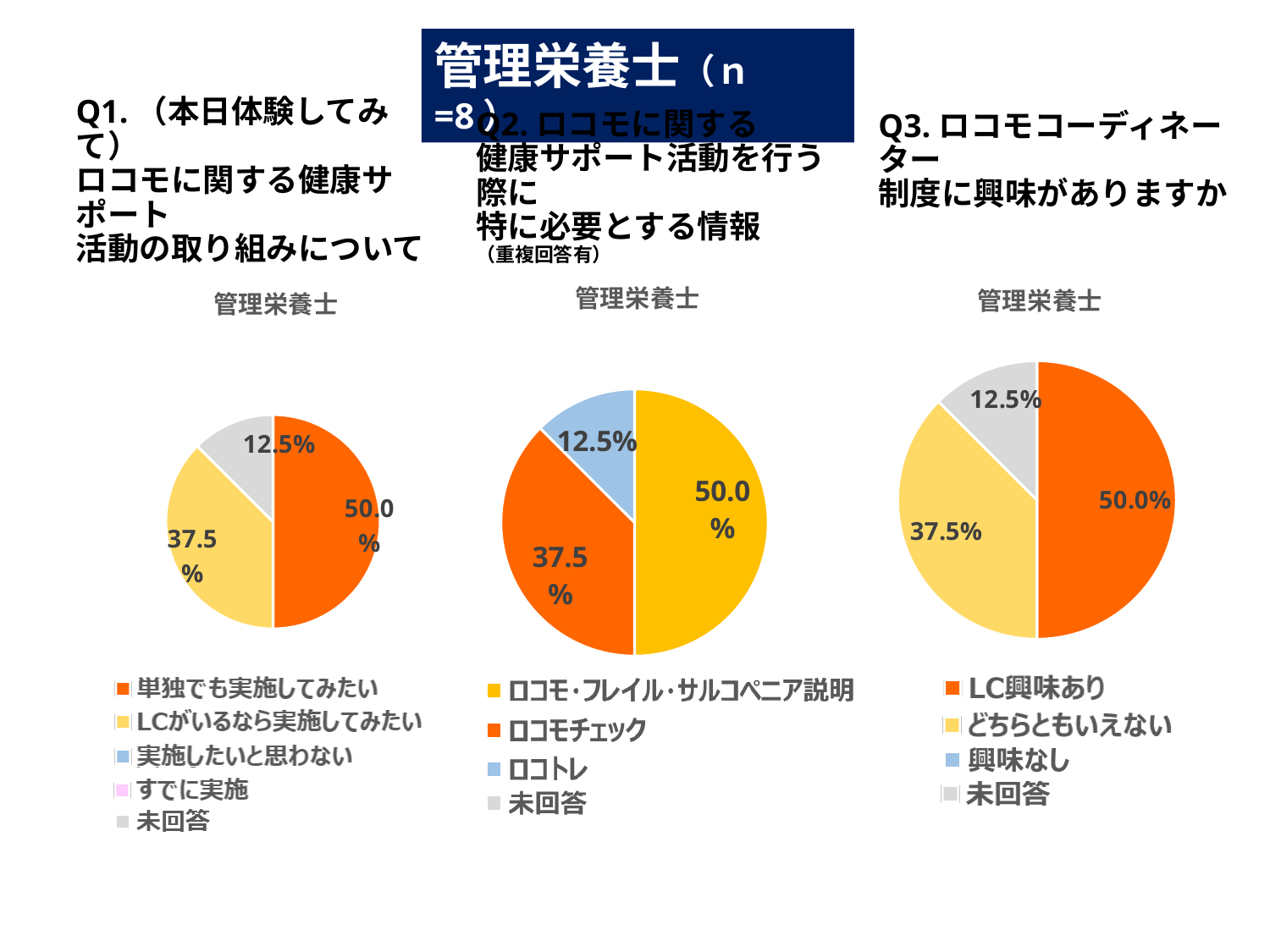
In the left pie chart (Q1), what share is labelled for 未回答? 12.5% In the right pie chart (Q3), what share is labelled for LC興味あり? 50.0% In the left pie chart (Q1), what share is labelled for LCがいるなら実施してみたい? 37.5% In the middle pie chart (Q2), which category has the smallest slice? ロコトレ In the left pie chart (Q1), which category has the largest slice? 単独でも実施してみたい In the left pie chart (Q1), how many entries does the legend list? 5 In the right pie chart (Q3), which is larger, どちらともいえない or 未回答? どちらともいえない In the middle pie chart (Q2), what is the difference between the shares for ロコモ・フレイル・サルコペニア説明 and ロコモチェック? 12.5% What type of chart is used for all three charts on the slide? Pie chart